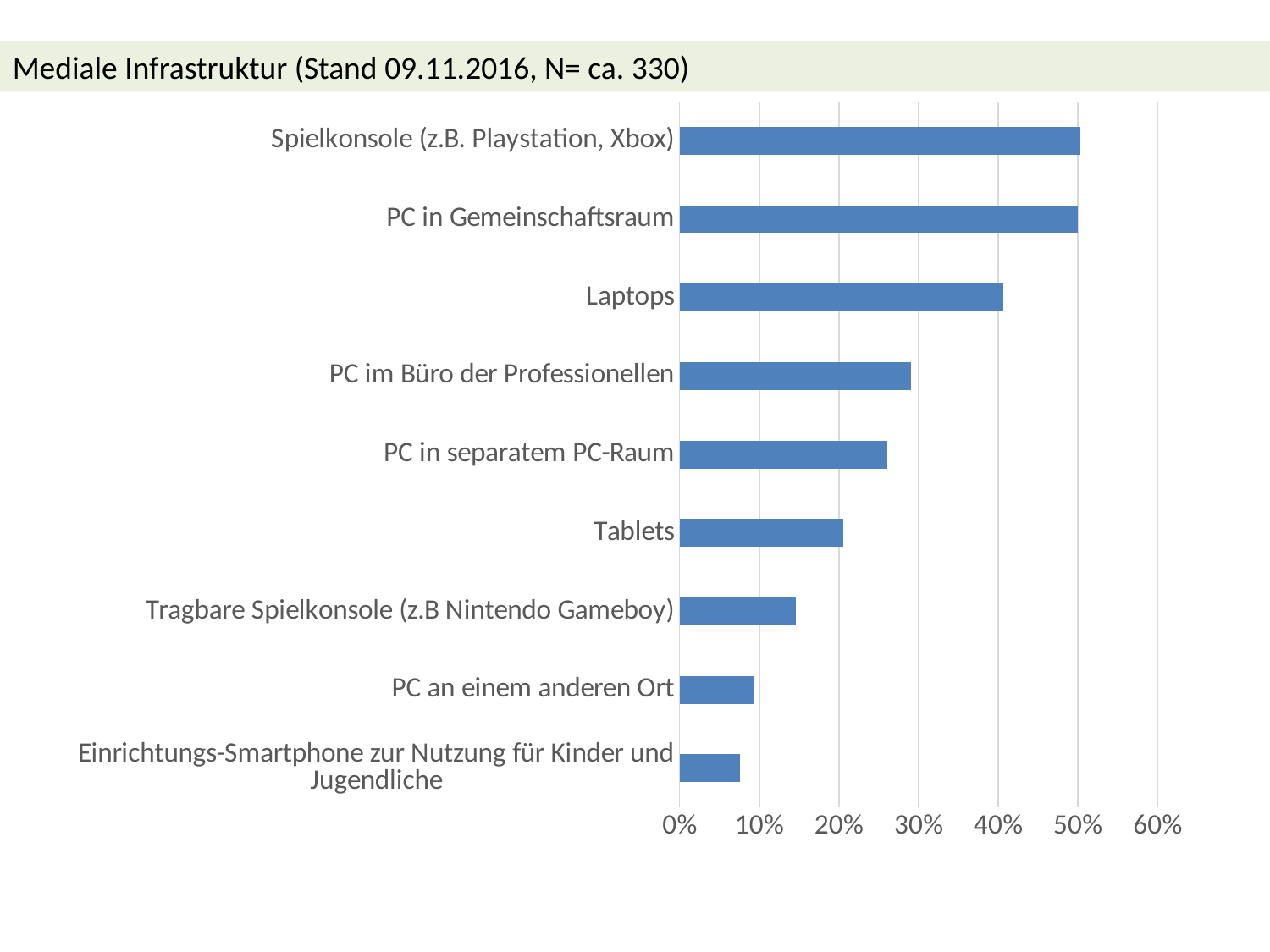
Is the value for Tablets greater or less than 30%? less What is the title of the slide containing the chart? Mediale Infrastruktur (Stand 09.11.2016, N= ca. 330) What kind of chart is shown on the slide? bar chart Is the value for Einrichtungs-Smartphone zur Nutzung für Kinder und Jugendliche greater or less than 10%? less Is the value for Spielkonsole (z.B. Playstation, Xbox) greater or less than 40%? greater Which has a larger value, Tablets or Tragbare Spielkonsole (z.B Nintendo Gameboy)? Tablets Which category has the lowest value in the chart? Einrichtungs-Smartphone zur Nutzung für Kinder und Jugendliche How many categories are plotted in the chart? 9 Which has a larger value, Laptops or Tablets? Laptops